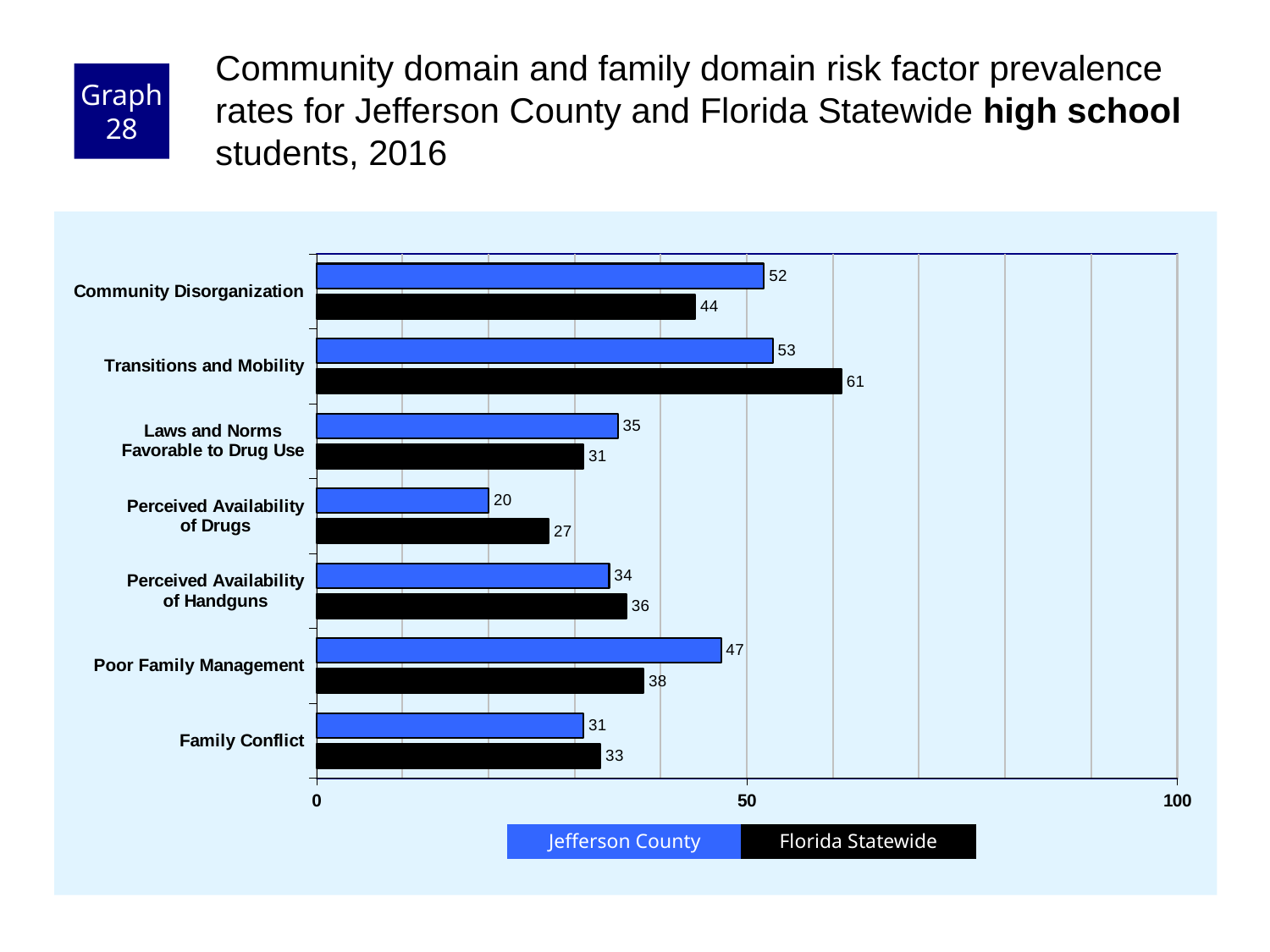
What is the Florida Statewide value for Transitions and Mobility? 61 Which colour represents Florida Statewide in the chart? Black For Perceived Availability of Drugs, which is larger: the Jefferson County value or the Florida Statewide value? Florida Statewide Which risk factor has the highest Jefferson County value? Transitions and Mobility Which risk factor has the lowest Florida Statewide value? Perceived Availability of Drugs What is the Florida Statewide value for Poor Family Management? 38 How many series does the legend list? 2 What is the difference between the Jefferson County and Florida Statewide values for Poor Family Management? 9 What is the Jefferson County value for Community Disorganization? 52 How many risk factors are shown on the chart? 7 What is the Jefferson County value for Perceived Availability of Drugs? 20 What kind of chart is shown on the slide? Bar chart